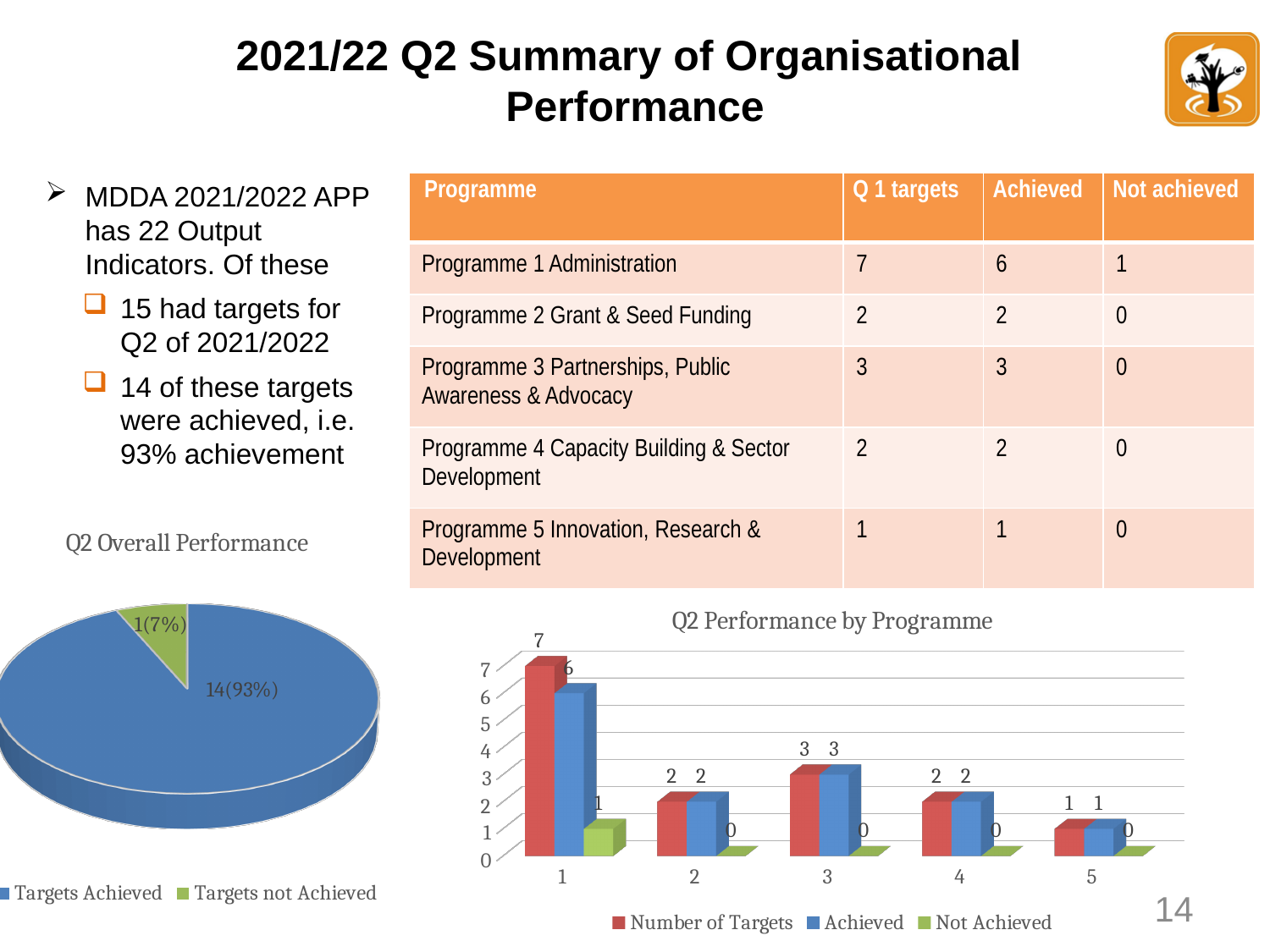
What kind of chart is 'Q2 Performance by Programme'? Bar chart In the 'Q2 Performance by Programme' chart, what is the difference between Number of Targets and Achieved for programme 1? 1 How many programme categories are shown on the x axis of the 'Q2 Performance by Programme' chart? 5 How many series does the legend of the 'Q2 Overall Performance' chart list? 2 In the 'Q2 Performance by Programme' chart, what is the Number of Targets for programme 1? 7 In the 'Q2 Performance by Programme' chart, which programme has the highest Number of Targets? 1 In the 'Q2 Performance by Programme' chart, what is the Achieved value for programme 1? 6 What kind of chart is 'Q2 Overall Performance'? Pie chart In the 'Q2 Overall Performance' pie chart, what share of the pie is Targets not Achieved? 7% In the 'Q2 Overall Performance' pie chart, what is the value shown for Targets Achieved? 14(93%) How many series does the legend of the 'Q2 Performance by Programme' chart list? 3 In the 'Q2 Performance by Programme' chart, which programme has the lowest Number of Targets? 5